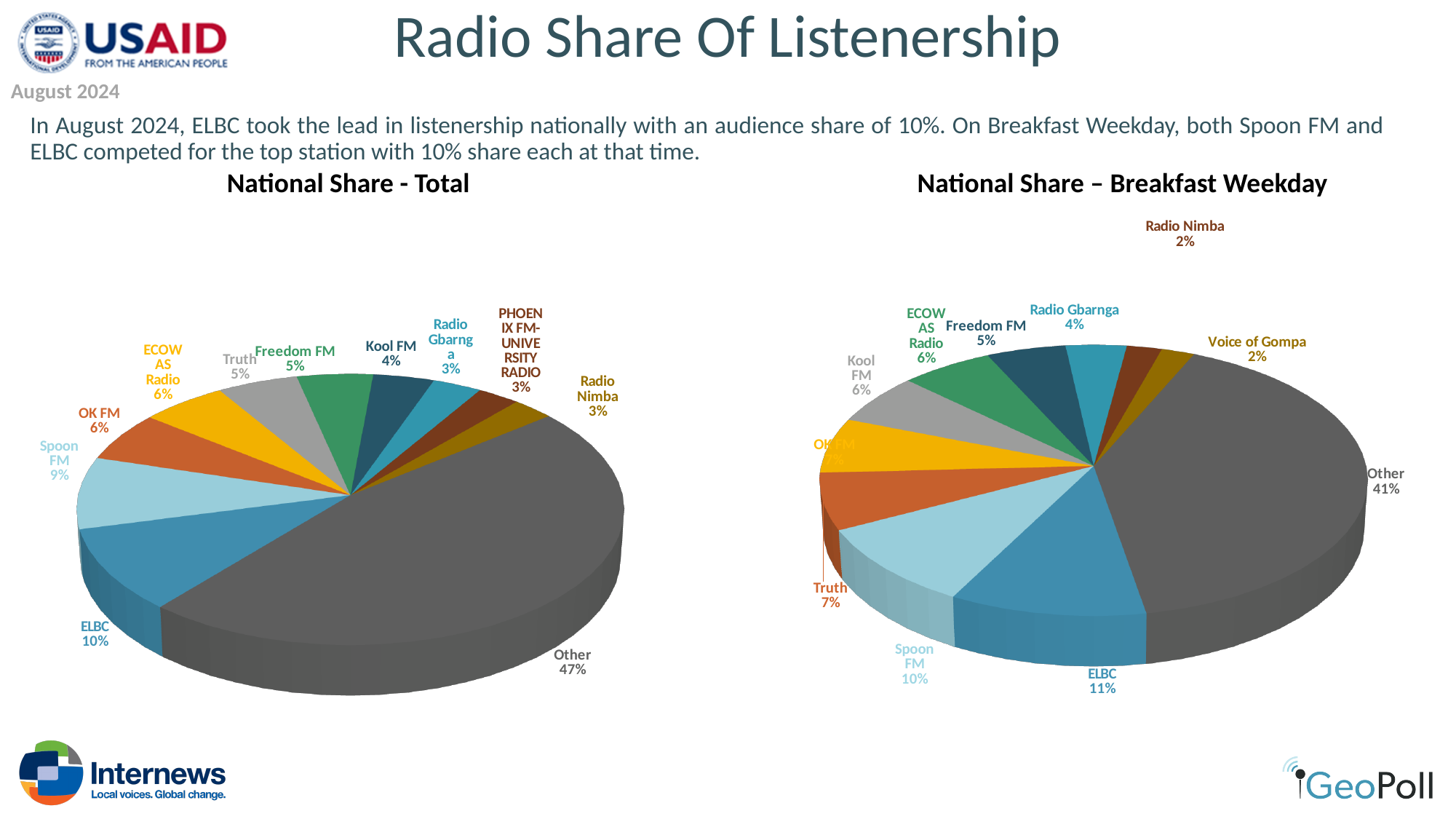
In the National Share – Breakfast Weekday chart, which is larger, the share of Truth or the share of Freedom FM? Truth In the National Share – Breakfast Weekday chart, what share does Voice of Gompa have? 2% In the National Share - Total chart, what share does ELBC have? 10% What type of chart is used for the National Share – Breakfast Weekday data? Pie chart What is the title of the chart on the left side of the slide? National Share - Total In the National Share - Total chart, what is the difference between the shares of ELBC and Kool FM? 6% In the National Share – Breakfast Weekday chart, what share does ELBC have? 11% In the National Share - Total chart, which station (excluding Other) has the largest share? ELBC In the National Share - Total chart, how many slices does the pie have? 11 In the National Share - Total chart, what share does Spoon FM have? 9% In the National Share – Breakfast Weekday chart, what is the difference between the shares of Other and ELBC? 30% In the National Share - Total chart, what is the share of the Other slice? 47%